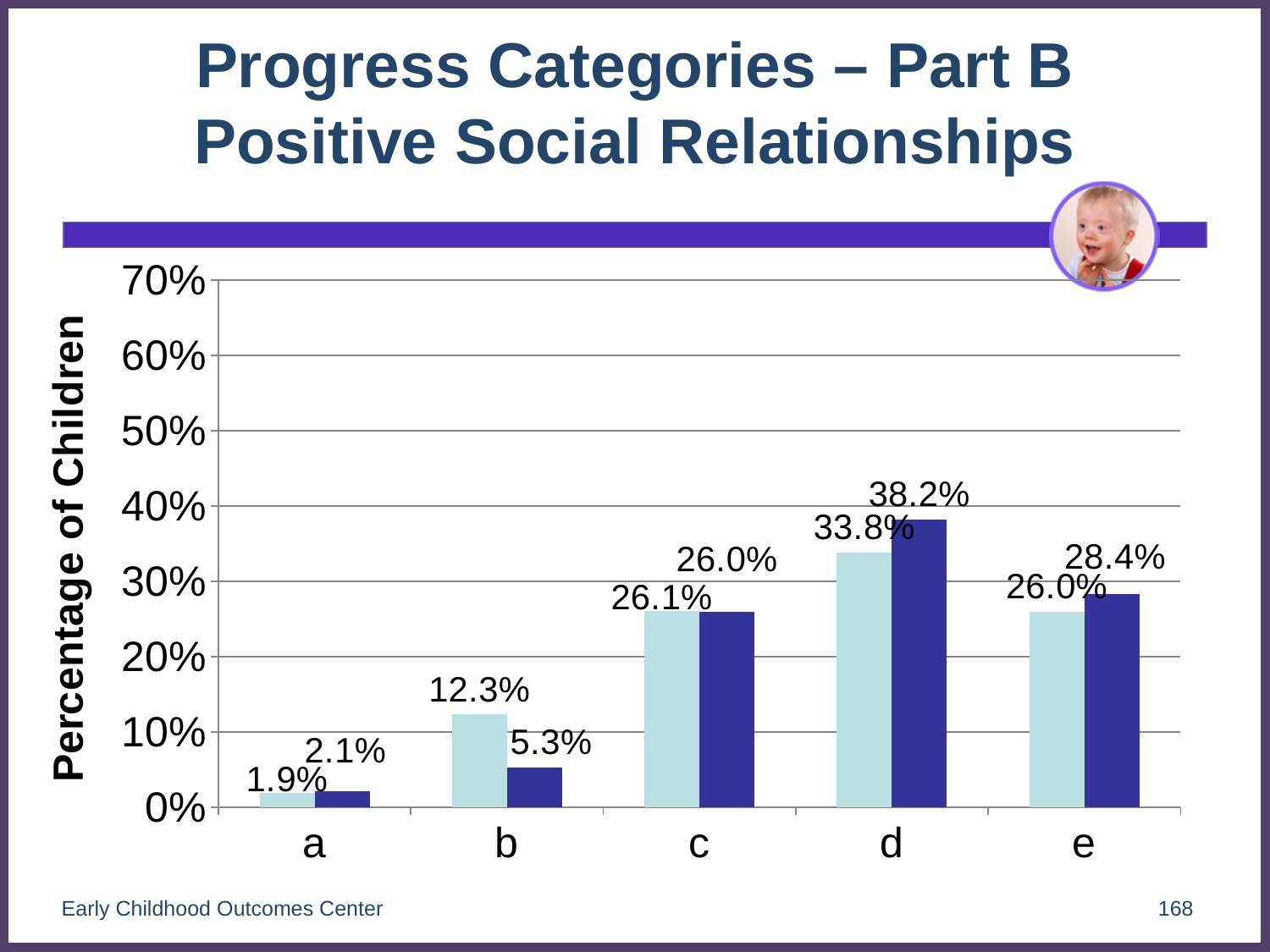
What kind of chart is shown on the slide? bar chart How many categories are shown on the x axis? 5 Which is larger for category e, the light blue bar or the dark blue bar? the dark blue bar What is the value of the light blue bar for category d? 33.8% What is the difference between the light blue and dark blue bars for category b? 7.0% What is the label of the y axis? Percentage of Children What is the value of the dark blue bar for category b? 5.3% What is the value of the light blue bar for category a? 1.9% Which category has the lowest light blue bar? a Which category has the highest dark blue bar? d What is the value of the dark blue bar for category e? 28.4% What is the difference between the dark blue bars for categories d and e? 9.8%